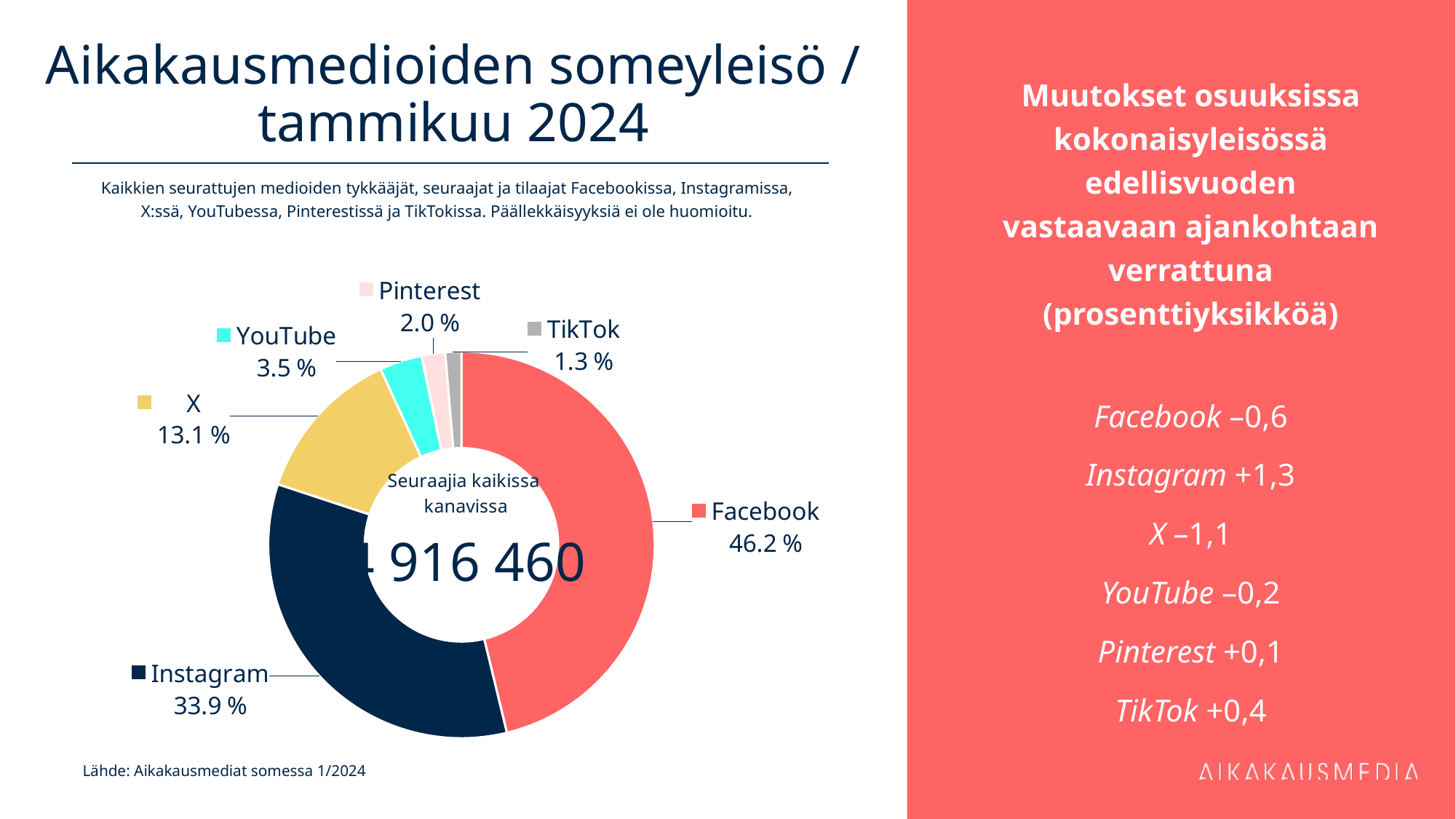
What share of the social media audience does X have? 13.1 % What share of the social media audience does Instagram have? 33.9 % Which channel has the largest share of the audience? Facebook What share of the social media audience does TikTok have? 1.3 % What is the difference in percentage points between Facebook's and Instagram's shares? 12.3 percentage points What share of the social media audience does Facebook have? 46.2 % What is the combined share of Pinterest and TikTok? 3.3 % Which has a larger share, YouTube or Pinterest? YouTube What share of the social media audience does YouTube have? 3.5 % What kind of chart is shown on the slide? Pie chart (donut) Which channel has the smallest share of the audience? TikTok How many channels (slices) are shown in the chart? 6